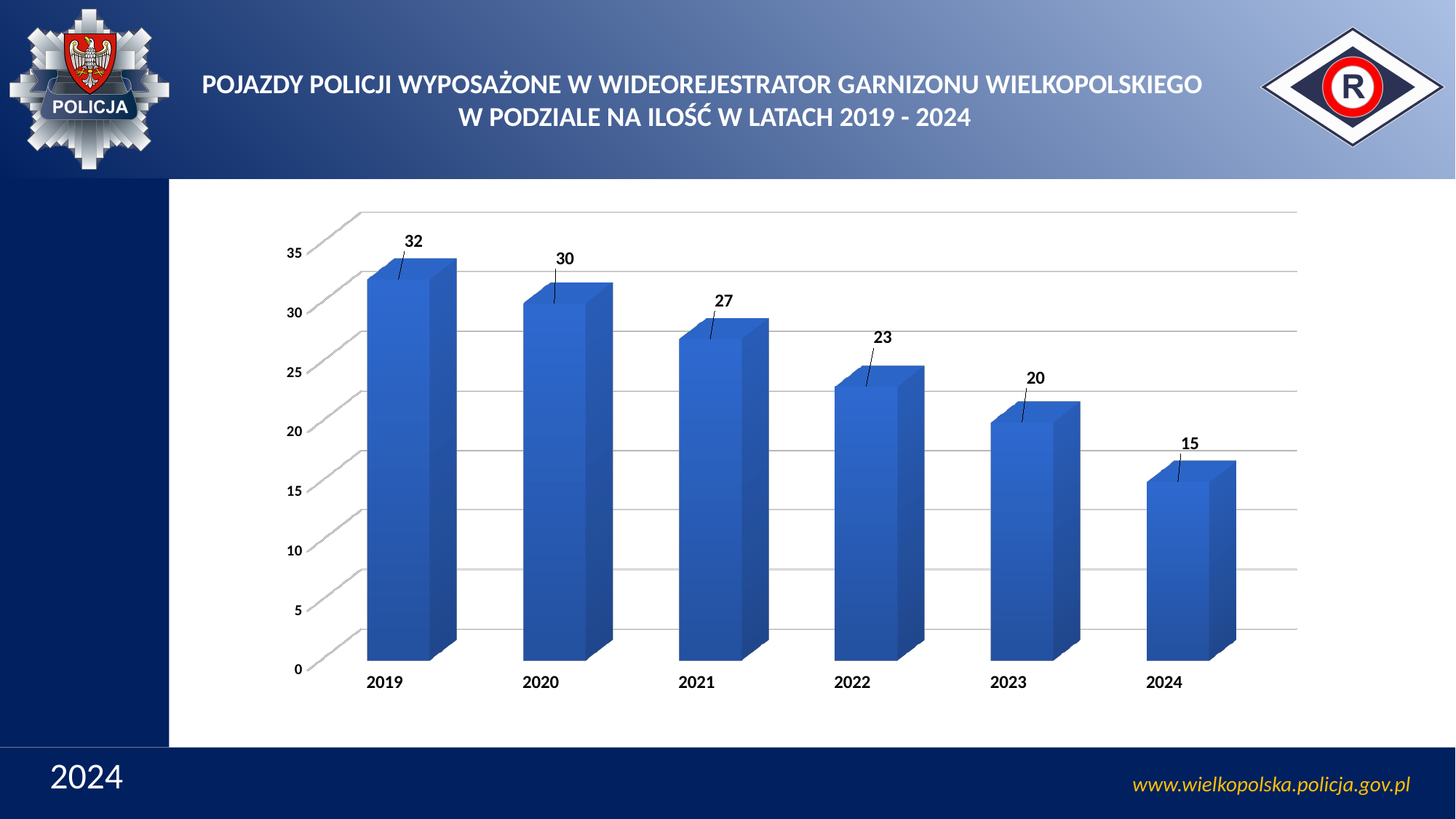
What is the difference between the values for 2020 and 2021? 3 What kind of chart is shown on the slide? bar chart What is the value for 2019? 32 Which is larger, the value for 2021 or the value for 2023? 2021 What is the value for 2022? 23 Is the value for 2022 greater or less than 25? less Do the values rise or fall from 2019 to 2024? fall Which year has the highest value? 2019 How many years are shown on the x axis? 6 What is the value for 2024? 15 What is the difference between the values for 2019 and 2024? 17 Which year has the lowest value? 2024